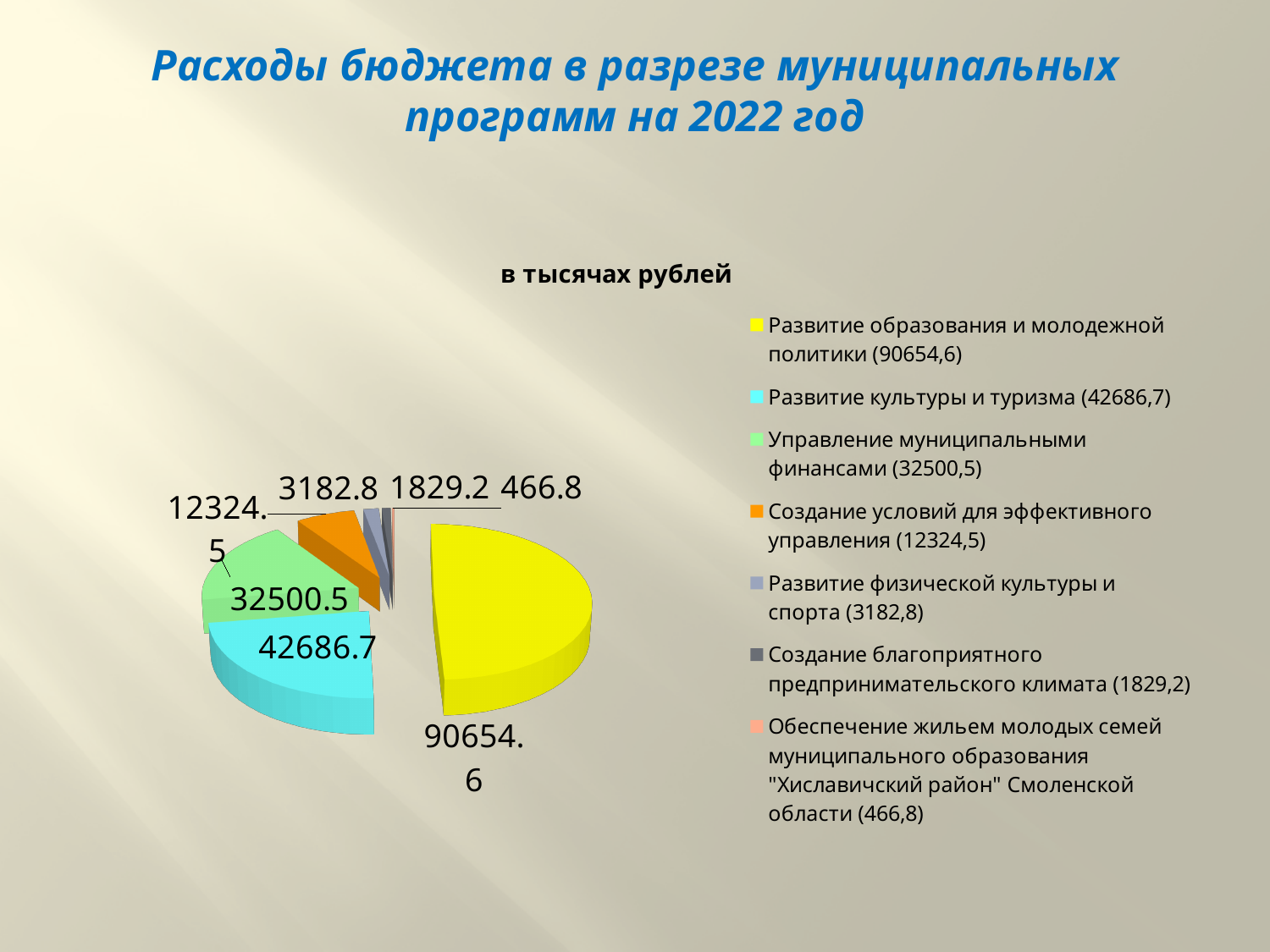
Which category has the largest slice of the pie? Развитие образования и молодежной политики What is the value for Развитие образования и молодежной политики? 90654.6 Which category has the smallest slice of the pie? Обеспечение жильем молодых семей муниципального образования "Хиславичский район" Смоленской области What kind of chart is shown on the slide? pie chart What is the value for Развитие культуры и туризма? 42686.7 In what units are the values on the chart expressed, according to the chart subtitle? в тысячах рублей What is the difference between the values for Развитие физической культуры и спорта and Создание благоприятного предпринимательского климата? 1353.6 What is the difference between the values for Развитие образования и молодежной политики and Развитие культуры и туризма? 47967.9 How many categories does the pie chart have? 7 What is the value for Развитие физической культуры и спорта? 3182.8 Which is larger: the value for Управление муниципальными финансами or the value for Создание условий для эффективного управления? Управление муниципальными финансами What is the value for Управление муниципальными финансами? 32500.5